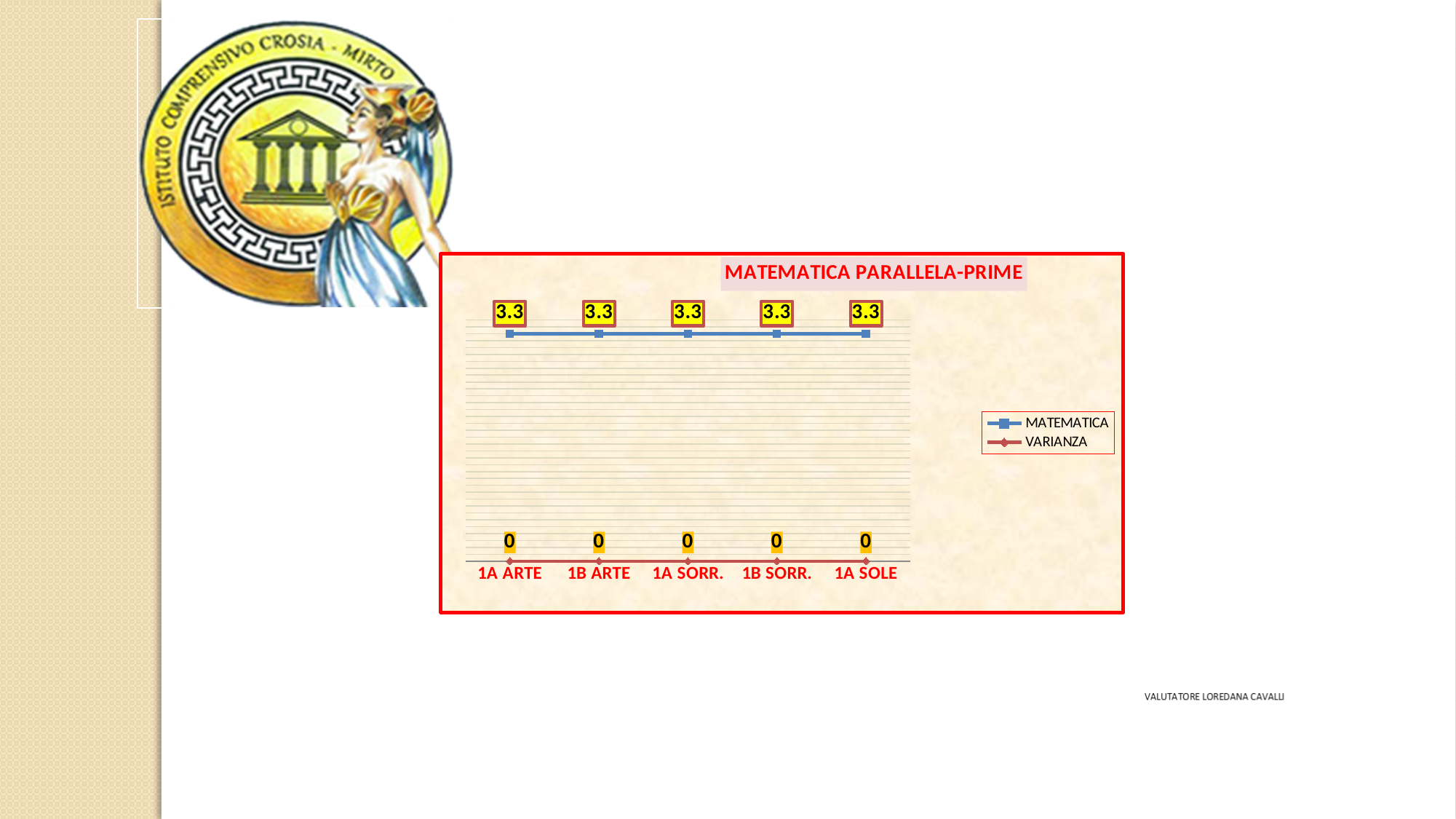
What is the VARIANZA value for 1B SORR.? 0 How many categories are shown on the x axis? 5 Which series are listed in the legend? MATEMATICA and VARIANZA Does the MATEMATICA line rise, fall, or stay flat across the categories? stays flat How many series does the legend list? 2 What is the MATEMATICA value for 1A ARTE? 3.3 Which series has the larger value for 1A SORR., MATEMATICA or VARIANZA? MATEMATICA What is the VARIANZA value for 1A SORR.? 0 What is the difference between the MATEMATICA and VARIANZA values for 1B ARTE? 3.3 What is the MATEMATICA value for 1A SOLE? 3.3 What type of chart is shown? line chart What is the title of the chart? MATEMATICA PARALLELA-PRIME